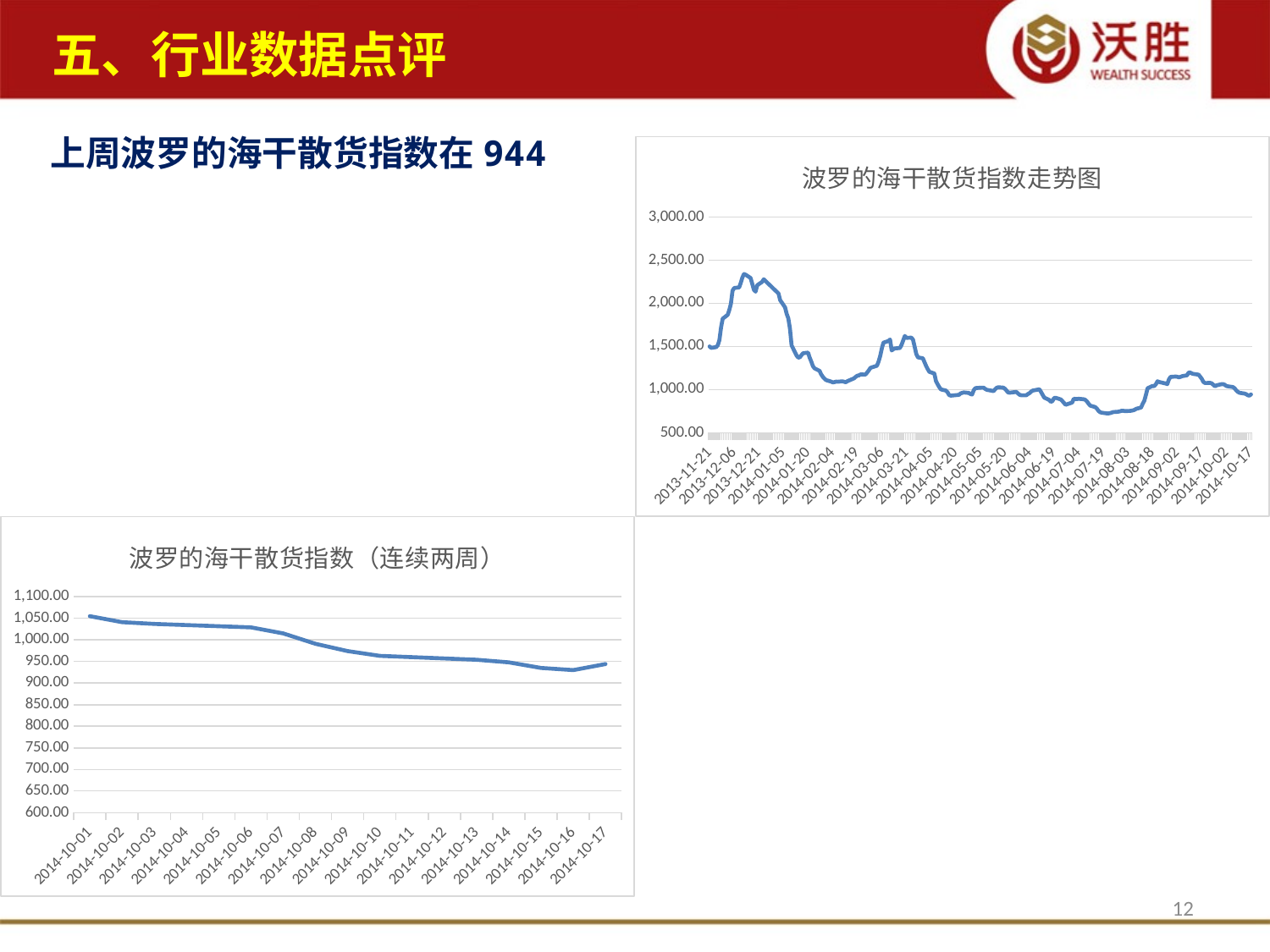
In the chart titled 波罗的海干散货指数走势图, is the value for 2014-07-19 greater or less than 1,000.00? less In the chart titled 波罗的海干散货指数（连续两周）, is the value for 2014-10-16 greater or less than 1,000.00? less What is the highest value shown on the y axis of the chart titled 波罗的海干散货指数（连续两周）? 1,100.00 In the chart titled 波罗的海干散货指数（连续两周）, how many dates are shown on the x axis? 17 What kind of chart is the chart titled 波罗的海干散货指数走势图? line chart In the chart titled 波罗的海干散货指数走势图, is the value for 2013-12-06 greater or less than 2,000.00? greater In the chart titled 波罗的海干散货指数（连续两周）, which is larger, the value for 2014-10-01 or the value for 2014-10-17? 2014-10-01 In the chart titled 波罗的海干散货指数（连续两周）, which date has the highest value? 2014-10-01 In the chart titled 波罗的海干散货指数走势图, which is larger, the value for 2013-12-21 or the value for 2014-10-17? 2013-12-21 What kind of chart is the chart titled 波罗的海干散货指数（连续两周）? line chart In the chart titled 波罗的海干散货指数（连续两周）, do the values generally rise or fall from 2014-10-01 to 2014-10-17? fall